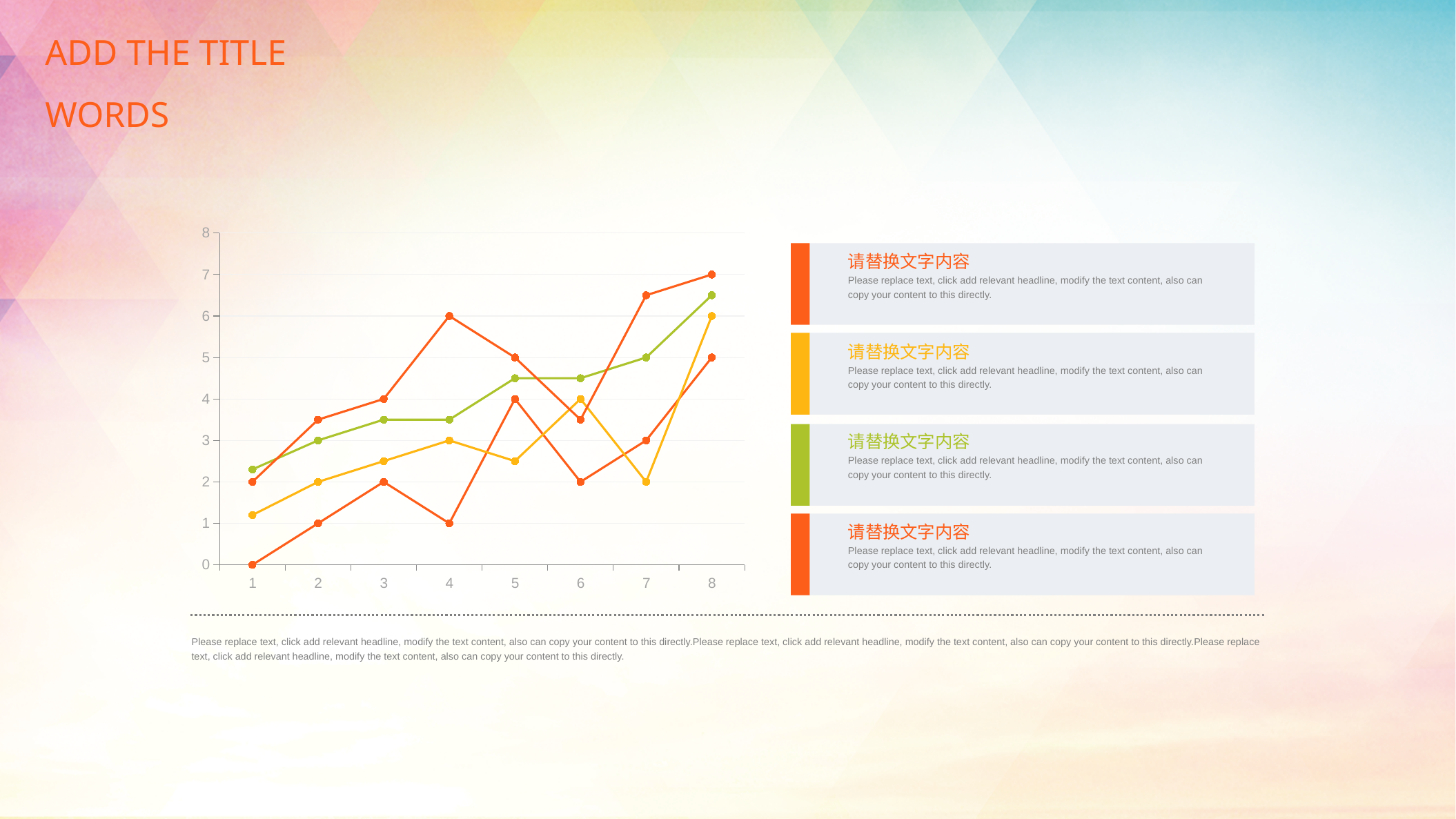
At x = 7, which line has the larger value, the green line or the yellow line? green line How many points are marked along the x axis of the chart? 8 What is the value of the yellow line at x = 6? 4 What is the highest value reached by any line on the chart? 7 By how much does the yellow line increase from x = 7 to x = 8? 4 Is the value of the green line at x = 8 greater or less than 6? greater Is the value of the yellow line at x = 1 greater or less than 2? less What is the value of the yellow line at x = 8? 6 How many lines are plotted on the chart? 4 What is the value of the green line at x = 7? 5 What kind of chart is shown on the slide? line chart What is the lowest value plotted on the chart? 0